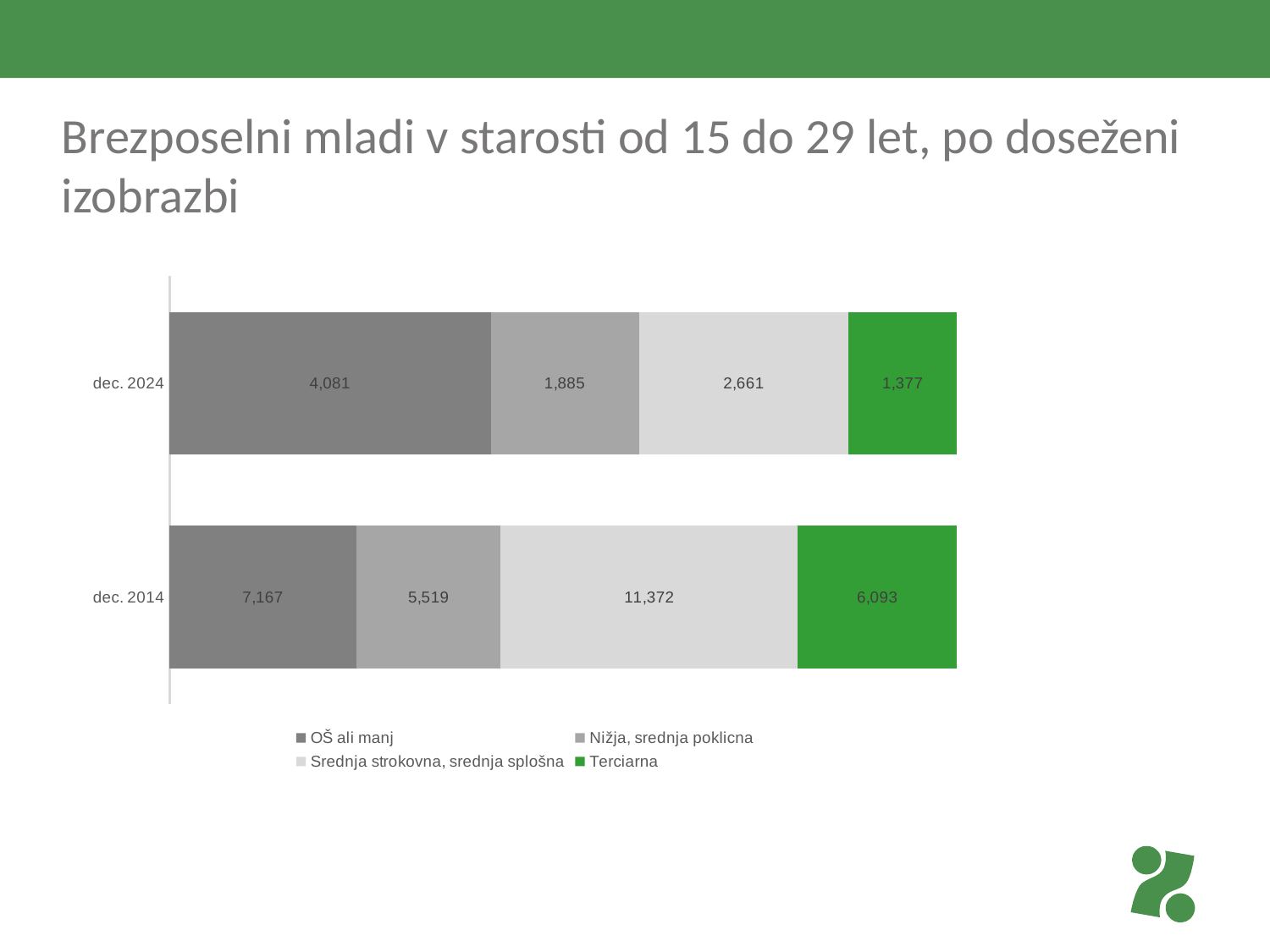
What is the total of the stacked bar for dec. 2014? 30,151 How many series does the legend list? 4 What is the total of the stacked bar for dec. 2024? 10,004 What is the value for "OŠ ali manj" in dec. 2024? 4,081 Which is larger: "Terciarna" in dec. 2014 or "Terciarna" in dec. 2024? dec. 2014 Which education group has the highest value in dec. 2014? Srednja strokovna, srednja splošna What is the value for "Terciarna" in dec. 2024? 1,377 Which education group has the lowest value in dec. 2024? Terciarna What is the difference between the "OŠ ali manj" values in dec. 2014 and dec. 2024? 3,086 What is the value for "Srednja strokovna, srednja splošna" in dec. 2014? 11,372 What kind of chart is shown on the slide? Stacked bar chart What is the value for "Nižja, srednja poklicna" in dec. 2014? 5,519